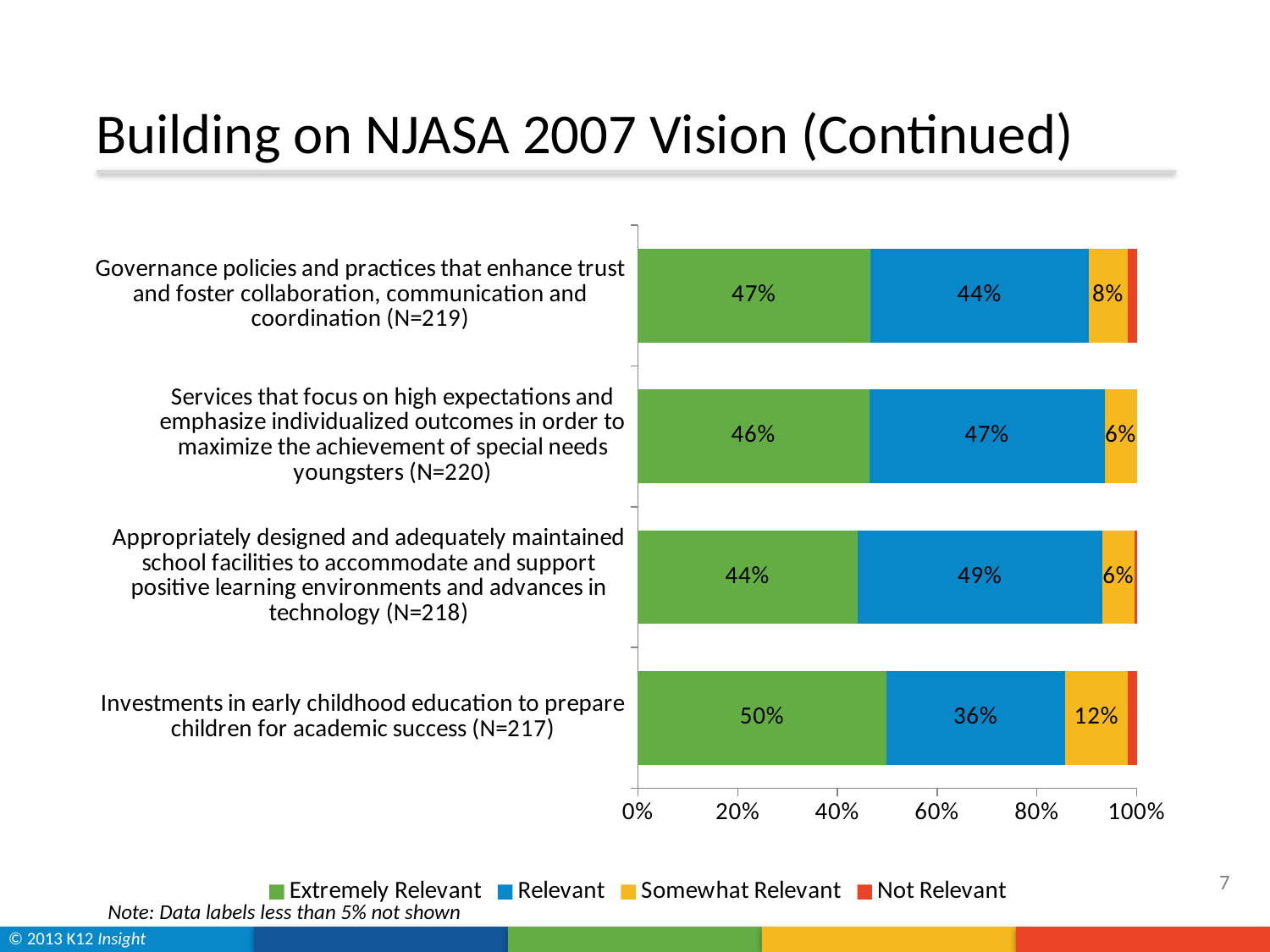
Which is larger for 'Appropriately designed and adequately maintained school facilities (N=218)': the Extremely Relevant percentage or the Relevant percentage? Relevant What is the difference between the Relevant percentage and the Extremely Relevant percentage for 'Investments in early childhood education to prepare children for academic success (N=217)'? 14% How many series does the legend list? 4 Which category has the highest Somewhat Relevant percentage? Investments in early childhood education to prepare children for academic success (N=217) What is the Relevant percentage for 'Appropriately designed and adequately maintained school facilities to accommodate and support positive learning environments and advances in technology (N=218)'? 49% Which category has the highest Extremely Relevant percentage? Investments in early childhood education to prepare children for academic success (N=217) Which category has the lowest Relevant percentage? Investments in early childhood education to prepare children for academic success (N=217) What is the Somewhat Relevant percentage for 'Governance policies and practices that enhance trust and foster collaboration, communication and coordination (N=219)'? 8% How many categories are shown in the chart? 4 What percentage of respondents rated 'Investments in early childhood education to prepare children for academic success (N=217)' as Extremely Relevant? 50% What is the Extremely Relevant percentage for 'Services that focus on high expectations and emphasize individualized outcomes in order to maximize the achievement of special needs youngsters (N=220)'? 46% What type of chart is shown on the slide? Stacked bar chart